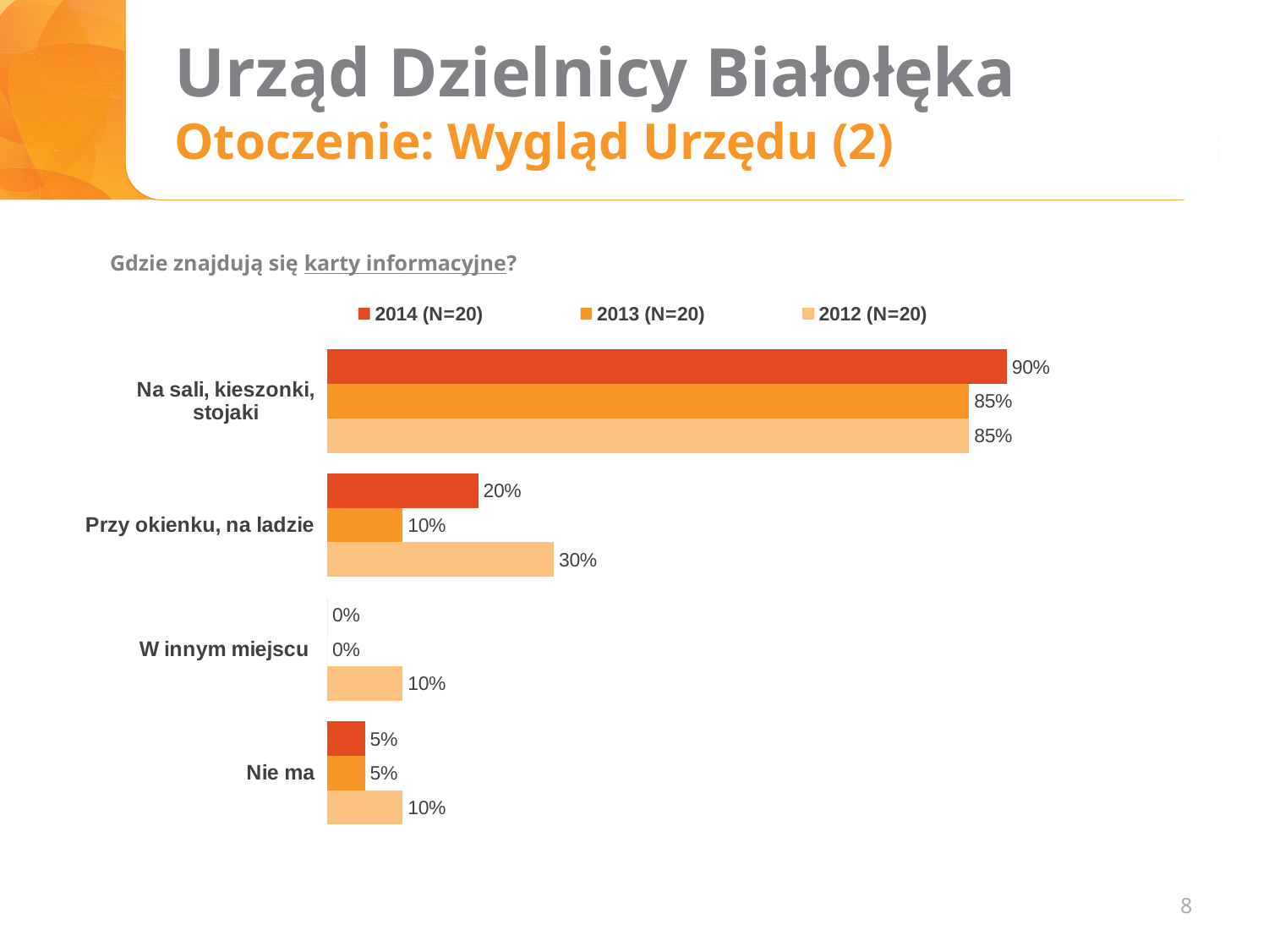
What is the value for "W innym miejscu" in the 2013 (N=20) series? 0% Which category has the highest value in the 2014 (N=20) series? Na sali, kieszonki, stojaki How many categories are shown on the chart? 4 What is the difference between the 2014 (N=20) and 2013 (N=20) values for "Przy okienku, na ladzie"? 10% What kind of chart is shown on the slide? Bar chart What is the value for "Przy okienku, na ladzie" in the 2012 (N=20) series? 30% Which category has the lowest value in the 2012 (N=20) series? W innym miejscu and Nie ma (both 10%) What is the value for "Nie ma" in the 2012 (N=20) series? 10% For "Przy okienku, na ladzie", which series has the larger value: 2014 (N=20) or 2012 (N=20)? 2012 (N=20) How many series does the legend list? 3 What question does the chart answer, as stated above it? Gdzie znajdują się karty informacyjne? What is the value for "Na sali, kieszonki, stojaki" in the 2014 (N=20) series? 90%